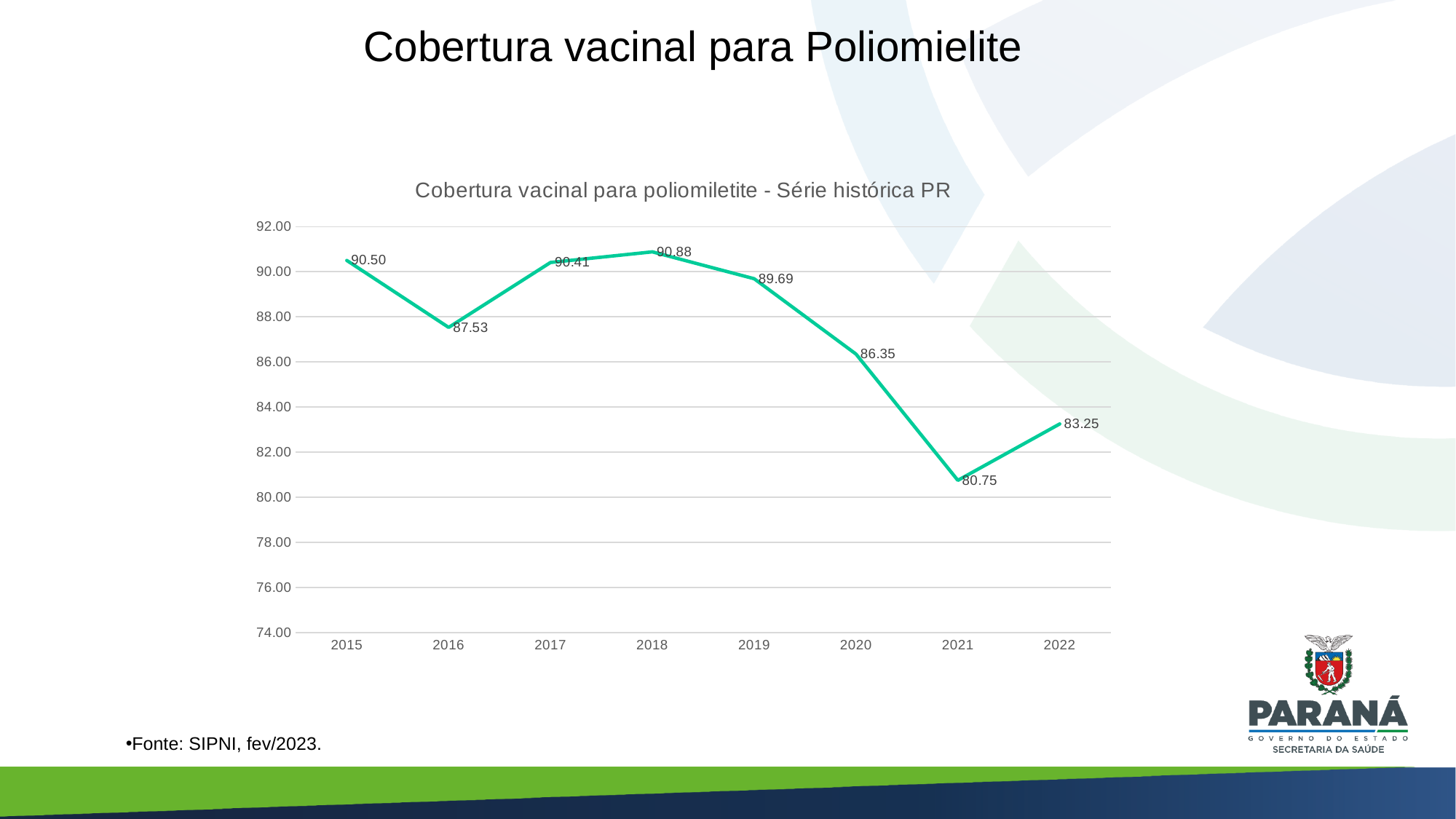
Which year has the lowest value? 2021 What is the value for 2021? 80.75 What is the value for 2015? 90.50 What kind of chart is shown? line chart What is the difference between the values for 2018 and 2021? 10.13 How many years are plotted on the chart? 8 What is the title of the chart? Cobertura vacinal para poliomiletite - Série histórica PR Is the value for 2019 greater or less than 88.00? greater Which is larger, the value for 2016 or the value for 2020? 2016 Which year has the highest value? 2018 What is the value for 2022? 83.25 Do the values rise or fall from 2018 to 2021? fall